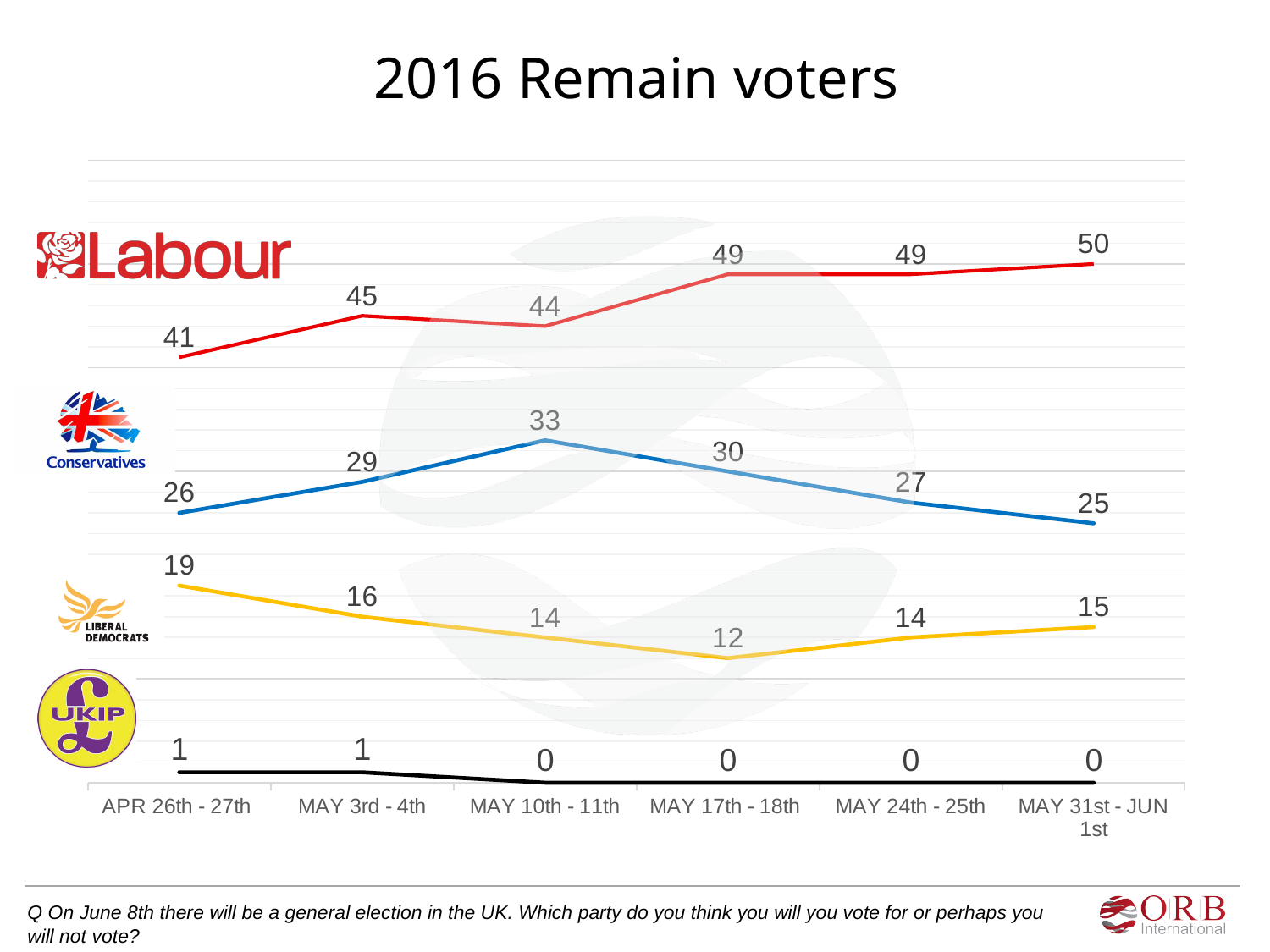
How many survey dates are shown on the x axis? 6 Does the Labour line generally rise or fall from APR 26th - 27th to MAY 31st - JUN 1st? Rise At which survey date does the Liberal Democrats line reach its lowest value? MAY 17th - 18th What is the value for Labour at MAY 17th - 18th? 49 How many party lines are plotted on the chart? 4 Which is larger at MAY 24th - 25th: the Conservatives value or the Liberal Democrats value? Conservatives At which survey date does the Conservatives line reach its highest value? MAY 10th - 11th What kind of chart is shown on the slide? Line chart What is the value for UKIP at MAY 3rd - 4th? 1 What is the value for Conservatives at MAY 10th - 11th? 33 What is the difference between the Labour value and the Conservatives value at MAY 31st - JUN 1st? 25 What is the value for Liberal Democrats at APR 26th - 27th? 19